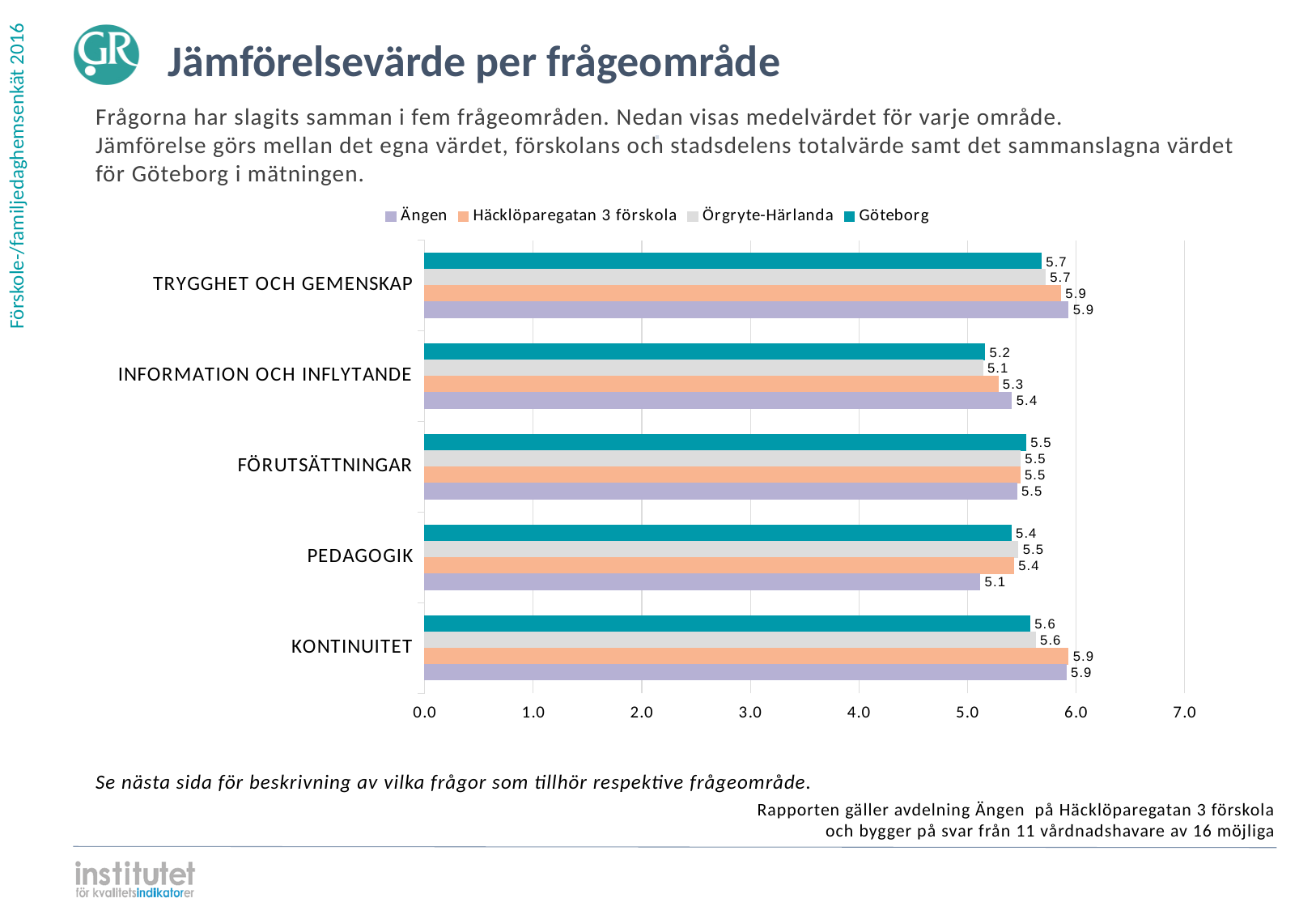
In the INFORMATION OCH INFLYTANDE category, which is larger: the value for Ängen or the value for Göteborg? Ängen What is the value for Göteborg in the INFORMATION OCH INFLYTANDE category? 5.2 Is the value for Ängen in the TRYGGHET OCH GEMENSKAP category greater or less than 5.0? greater How many series does the legend list? 4 What kind of chart is shown on the slide? Bar chart In which category does Göteborg have its lowest value? INFORMATION OCH INFLYTANDE What is the value for Örgryte-Härlanda in the TRYGGHET OCH GEMENSKAP category? 5.7 In which category does Ängen have its lowest value? PEDAGOGIK What is the difference between the Göteborg value and the Ängen value in the PEDAGOGIK category? 0.3 What is the value for Ängen in the PEDAGOGIK category? 5.1 How many question areas (categories) are shown on the chart? 5 What is the value for Häcklöparegatan 3 förskola in the KONTINUITET category? 5.9